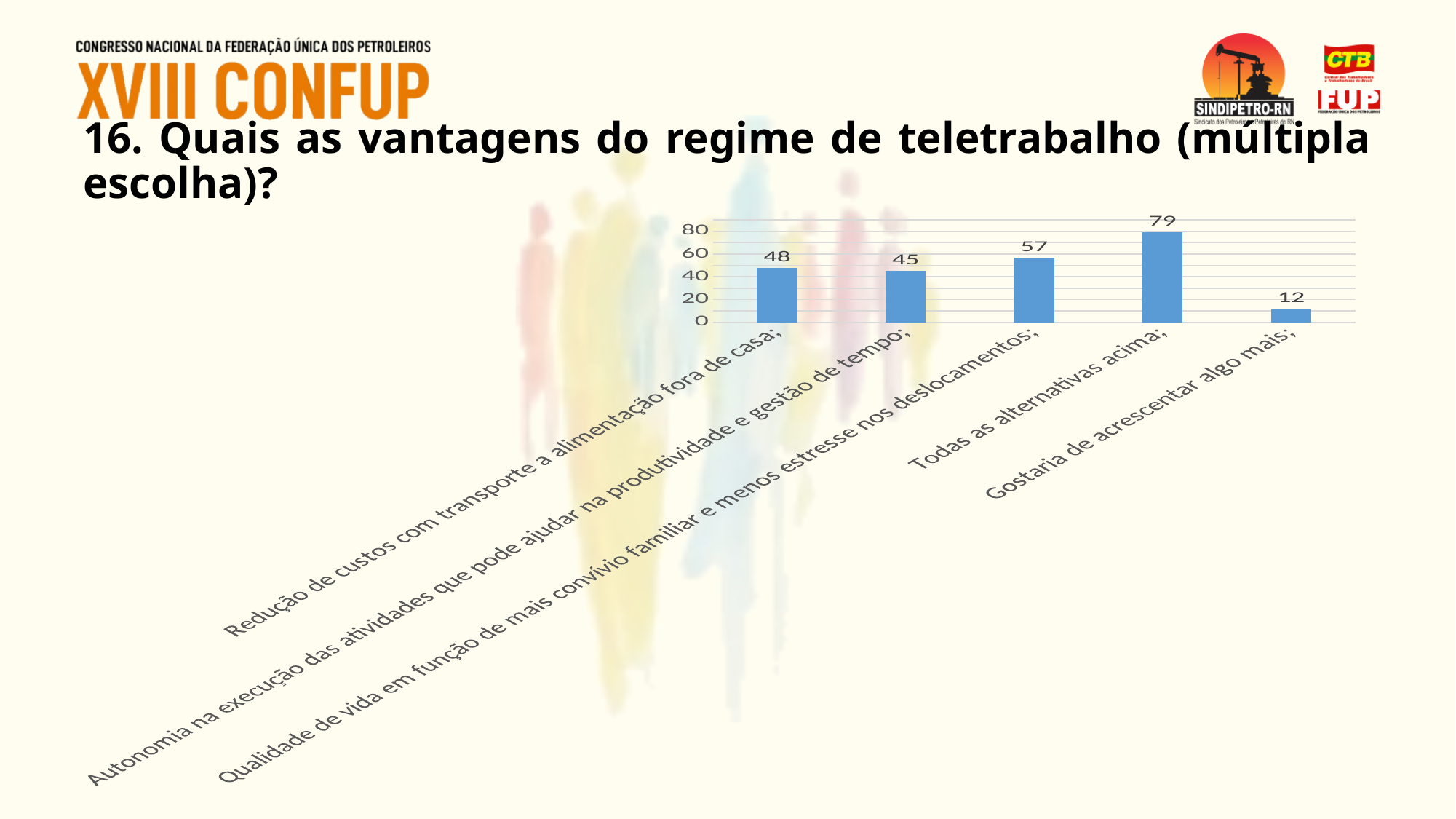
What is the value for "Gostaria de acrescentar algo mais"? 12 What kind of chart is shown on the slide? Bar chart Which is larger, the value for "Redução de custos com transporte a alimentação fora de casa" or the value for "Autonomia na execução das atividades que pode ajudar na produtividade e gestão de tempo"? Redução de custos com transporte a alimentação fora de casa How many categories are shown in the chart? 5 What is the highest value shown on the vertical axis? 80 Which category has the lowest value? Gostaria de acrescentar algo mais What is the value for "Redução de custos com transporte a alimentação fora de casa"? 48 What is the difference between the values for "Todas as alternativas acima" and "Gostaria de acrescentar algo mais"? 67 Which category has the highest value? Todas as alternativas acima What is the difference between the values for "Qualidade de vida em função de mais convívio familiar e menos estresse nos deslocamentos" and "Autonomia na execução das atividades que pode ajudar na produtividade e gestão de tempo"? 12 What is the value for "Todas as alternativas acima"? 79 What is the value for "Qualidade de vida em função de mais convívio familiar e menos estresse nos deslocamentos"? 57